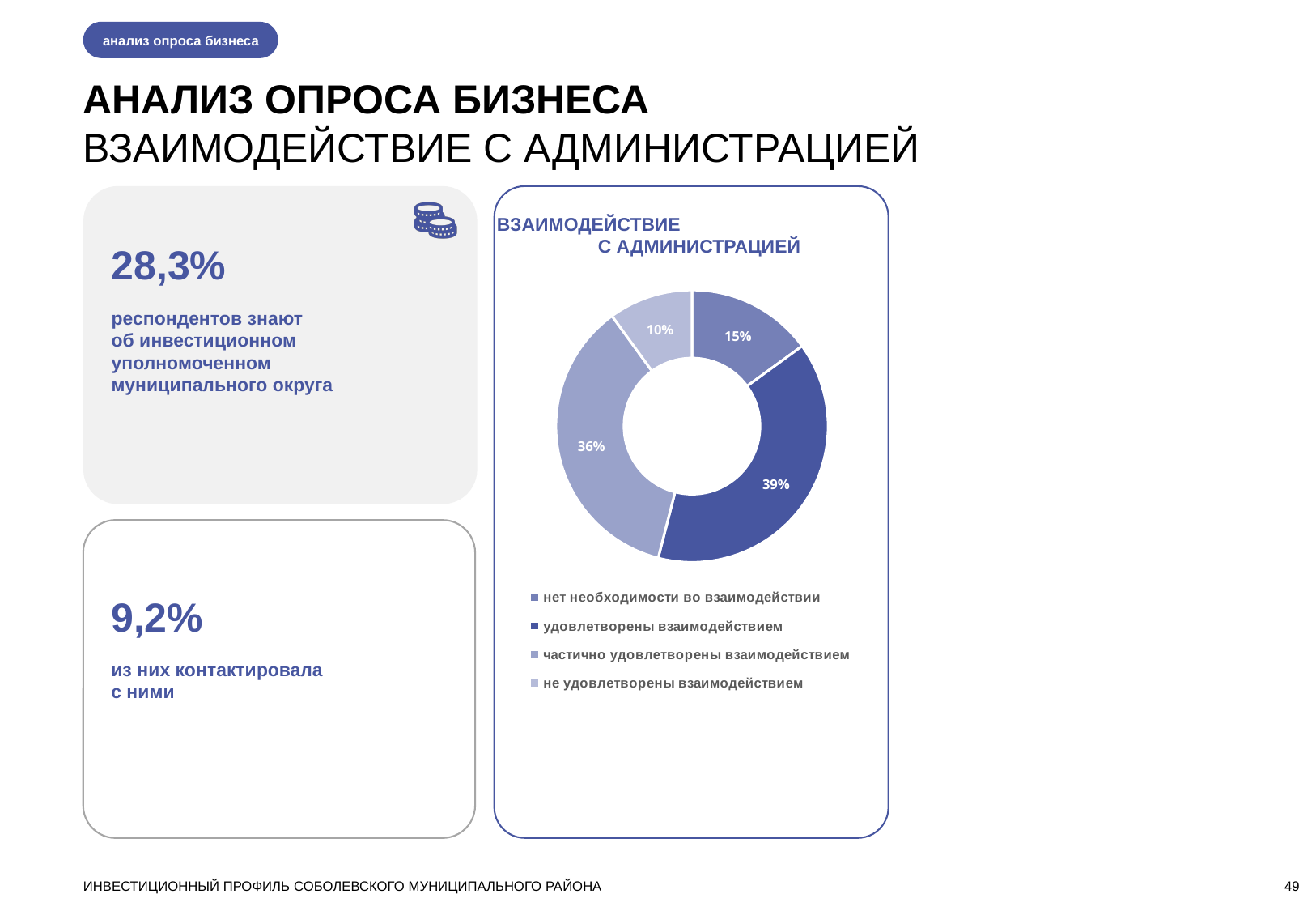
What share of respondents are 'не удовлетворены взаимодействием'? 10% What share of respondents are 'удовлетворены взаимодействием'? 39% Which category has the largest share of the chart? удовлетворены взаимодействием What share of respondents are 'частично удовлетворены взаимодействием'? 36% What is the difference between the shares for 'удовлетворены взаимодействием' and 'не удовлетворены взаимодействием'? 29% What is the title of the chart? ВЗАИМОДЕЙСТВИЕ С АДМИНИСТРАЦИЕЙ What share of respondents answered 'нет необходимости во взаимодействии'? 15% What kind of chart is shown on the slide? Doughnut (pie) chart Which category has the smallest share of the chart? не удовлетворены взаимодействием Which is larger: the share for 'нет необходимости во взаимодействии' or for 'частично удовлетворены взаимодействием'? частично удовлетворены взаимодействием How many entries does the legend list? 4 How many slices does the chart have? 4